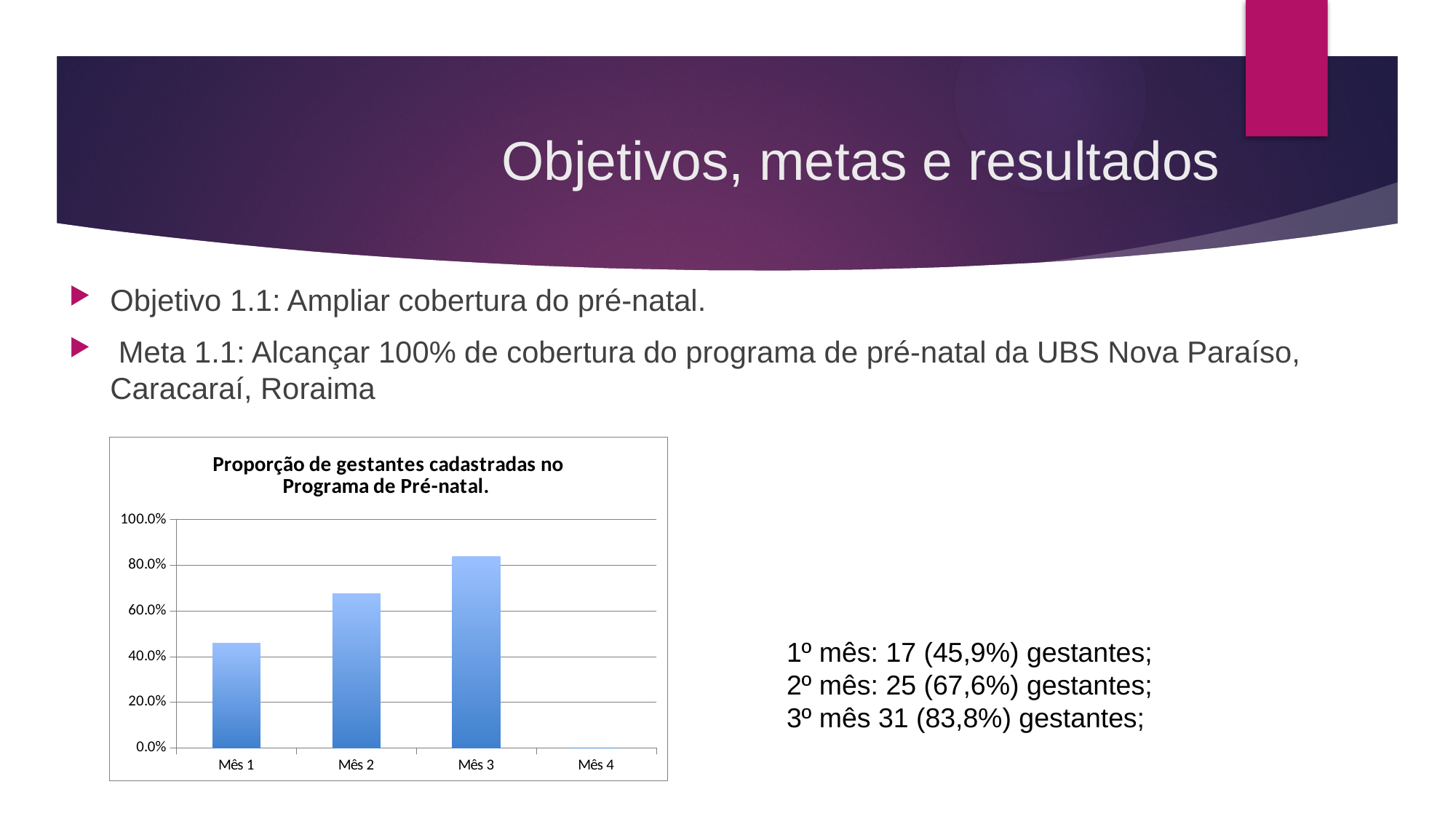
Which month has the highest bar in the chart? Mês 3 Is the value for Mês 3 greater or less than 100.0%? less Is the value for Mês 1 greater or less than 40.0%? greater How many categories are shown on the x axis of the chart? 4 Is the value for Mês 2 greater or less than 60.0%? greater Which is larger, the value for Mês 2 or the value for Mês 1? Mês 2 Among the bars plotted, which month has the lowest value? Mês 1 What is the title of the chart? Proporção de gestantes cadastradas no Programa de Pré-natal. What kind of chart is shown on the slide? Bar chart Do the bar values rise or fall from Mês 1 to Mês 3? Rise